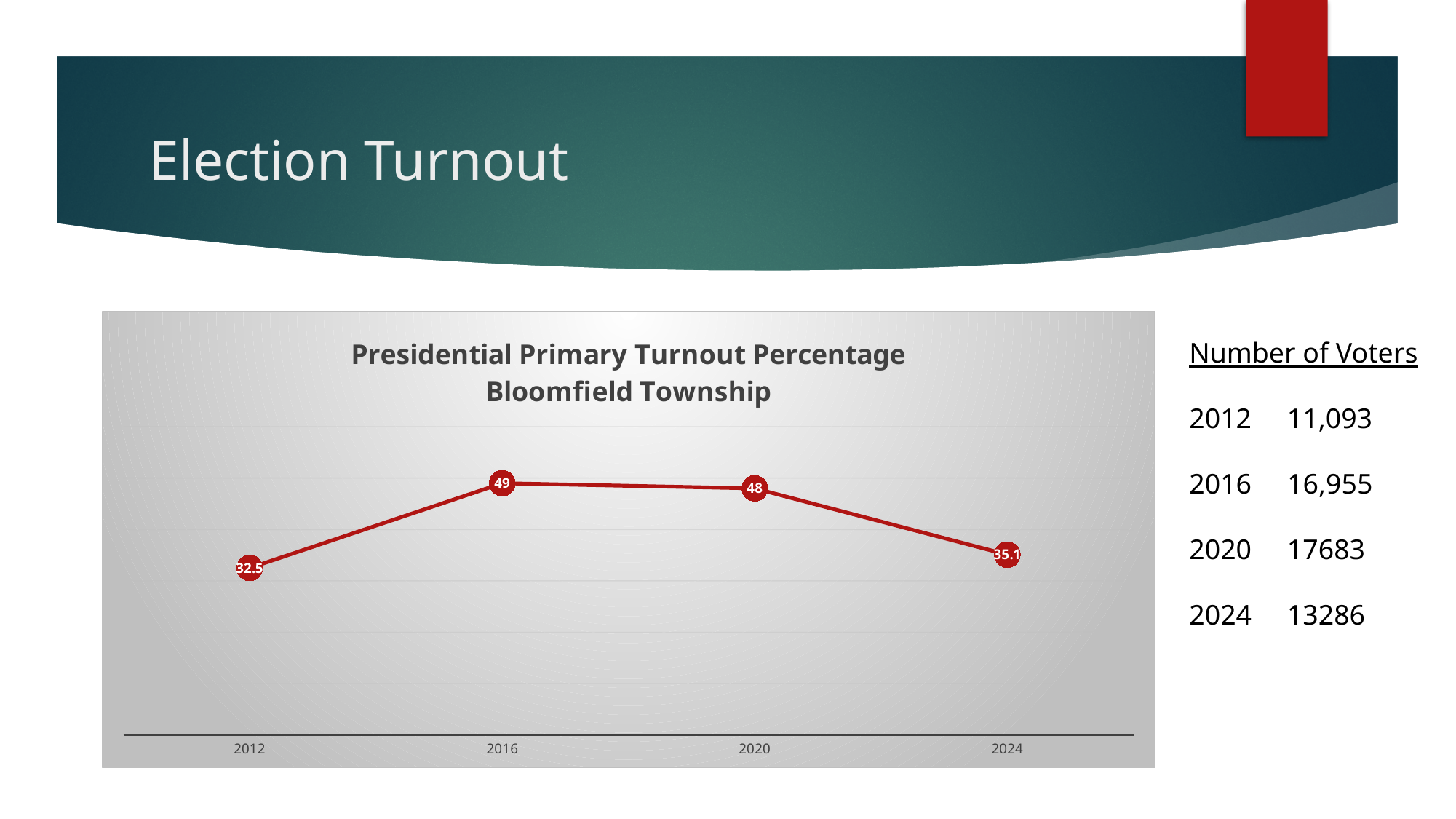
What kind of chart is shown on the slide? Line chart How many years are plotted on the chart? 4 What is the turnout percentage for 2020? 48 What is the title of the chart? Presidential Primary Turnout Percentage Bloomfield Township What is the turnout percentage for 2024? 35.1 Which year has the lowest turnout percentage? 2012 What is the difference between the turnout percentage in 2020 and in 2024? 12.9 Which year has a higher turnout percentage, 2012 or 2024? 2024 What is the difference between the turnout percentage in 2016 and in 2012? 16.5 Which year has the highest turnout percentage? 2016 What is the turnout percentage for 2012? 32.5 What is the turnout percentage for 2016? 49